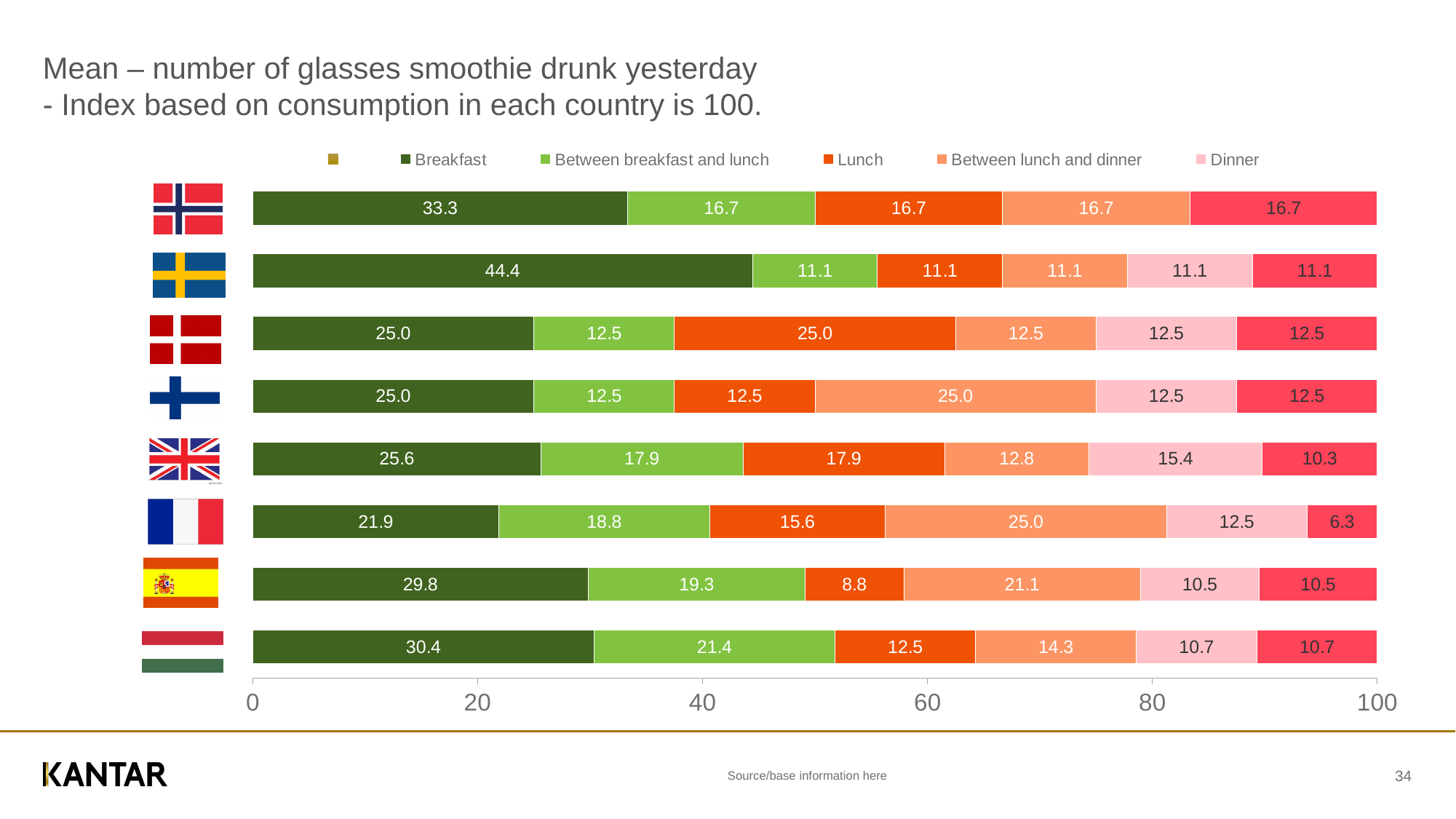
Which has the larger Breakfast value: the top bar (Norwegian flag) or the third bar from the top (Danish flag)? The top bar (Norwegian flag) How many country bars are plotted in the chart? 8 What is the Breakfast value for the second bar from the top (Swedish flag)? 44.4 Which bar has the highest Breakfast value? The second bar from the top (Swedish flag) What is the Between lunch and dinner value for the sixth bar from the top (French flag)? 25.0 What is the Dinner value for the fifth bar from the top (UK flag)? 15.4 Which bar has the lowest Lunch value? The seventh bar from the top (Spanish flag) What is the Lunch value for the bottom bar (Hungarian flag)? 12.5 In the bottom bar (Hungarian flag), what is the difference between the Breakfast value and the Between breakfast and lunch value? 9.0 How much larger is the Breakfast value of the second bar from the top (Swedish flag) than that of the top bar (Norwegian flag)? 11.1 What type of chart is shown on the slide? Stacked bar chart What is the maximum value shown on the x axis? 100